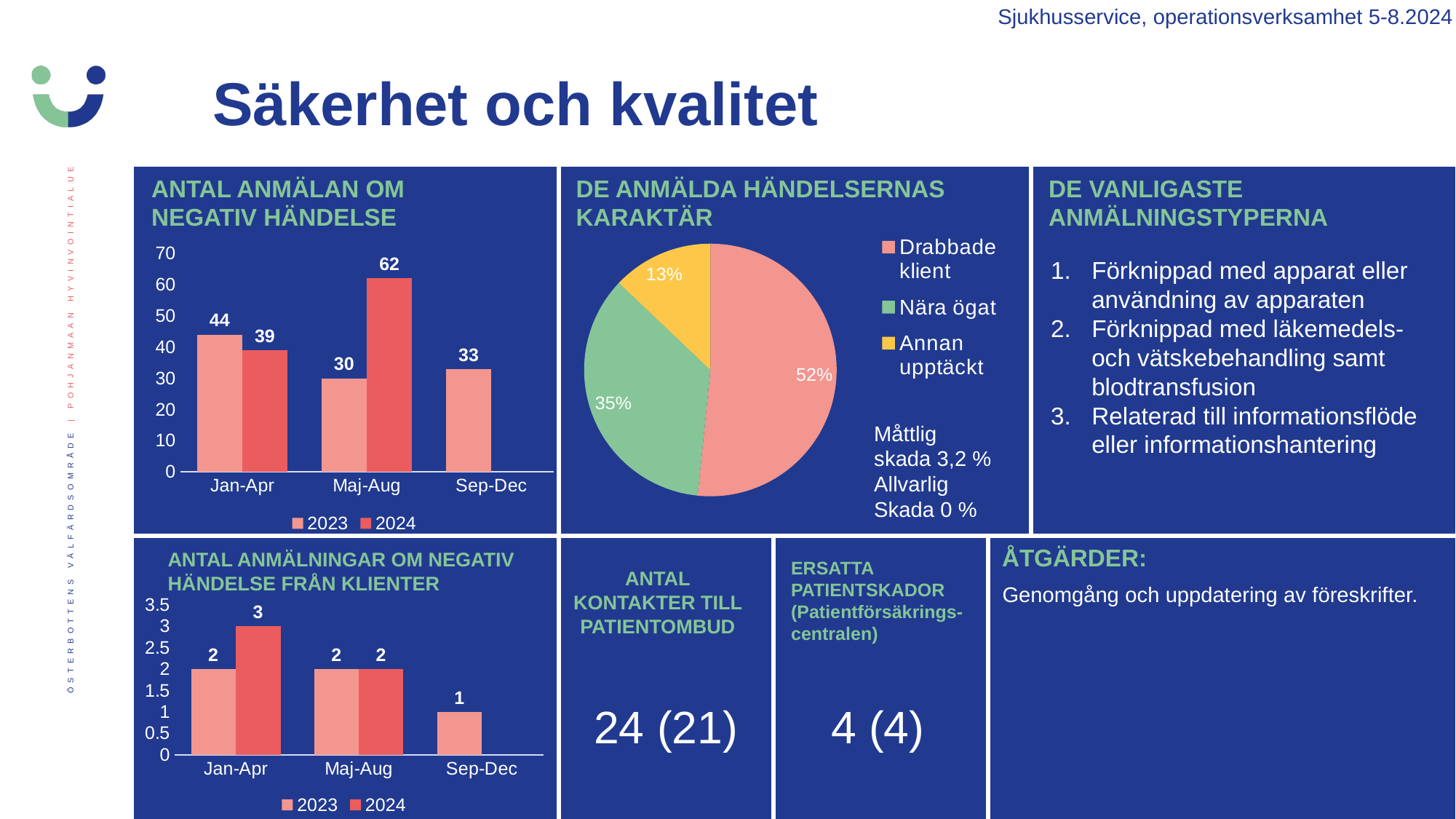
In the chart 'ANTAL ANMÄLNINGAR OM NEGATIV HÄNDELSE FRÅN KLIENTER', do the 2023 values rise or fall from Maj-Aug to Sep-Dec? Fall In the chart 'ANTAL ANMÄLAN OM NEGATIV HÄNDELSE', what is the value for 2024 in Maj-Aug? 62 In the pie chart 'DE ANMÄLDA HÄNDELSERNAS KARAKTÄR', which category has the smallest slice? Annan upptäckt What kind of chart is 'DE ANMÄLDA HÄNDELSERNAS KARAKTÄR'? Pie chart In the chart 'ANTAL ANMÄLNINGAR OM NEGATIV HÄNDELSE FRÅN KLIENTER', what is the value for 2024 in Jan-Apr? 3 In the chart 'ANTAL ANMÄLAN OM NEGATIV HÄNDELSE', which period has the highest 2023 value? Jan-Apr How many series does the legend of the chart 'ANTAL ANMÄLAN OM NEGATIV HÄNDELSE' list? 2 In the chart 'ANTAL ANMÄLAN OM NEGATIV HÄNDELSE', what is the difference between the 2024 and 2023 values in Maj-Aug? 32 How many slices does the pie chart 'DE ANMÄLDA HÄNDELSERNAS KARAKTÄR' have? 3 In the pie chart 'DE ANMÄLDA HÄNDELSERNAS KARAKTÄR', what share is 'Nära ögat'? 35% In the chart 'ANTAL ANMÄLAN OM NEGATIV HÄNDELSE', what is the value for 2023 in Sep-Dec? 33 In the chart 'ANTAL ANMÄLAN OM NEGATIV HÄNDELSE', which is larger in Jan-Apr: 2023 or 2024? 2023